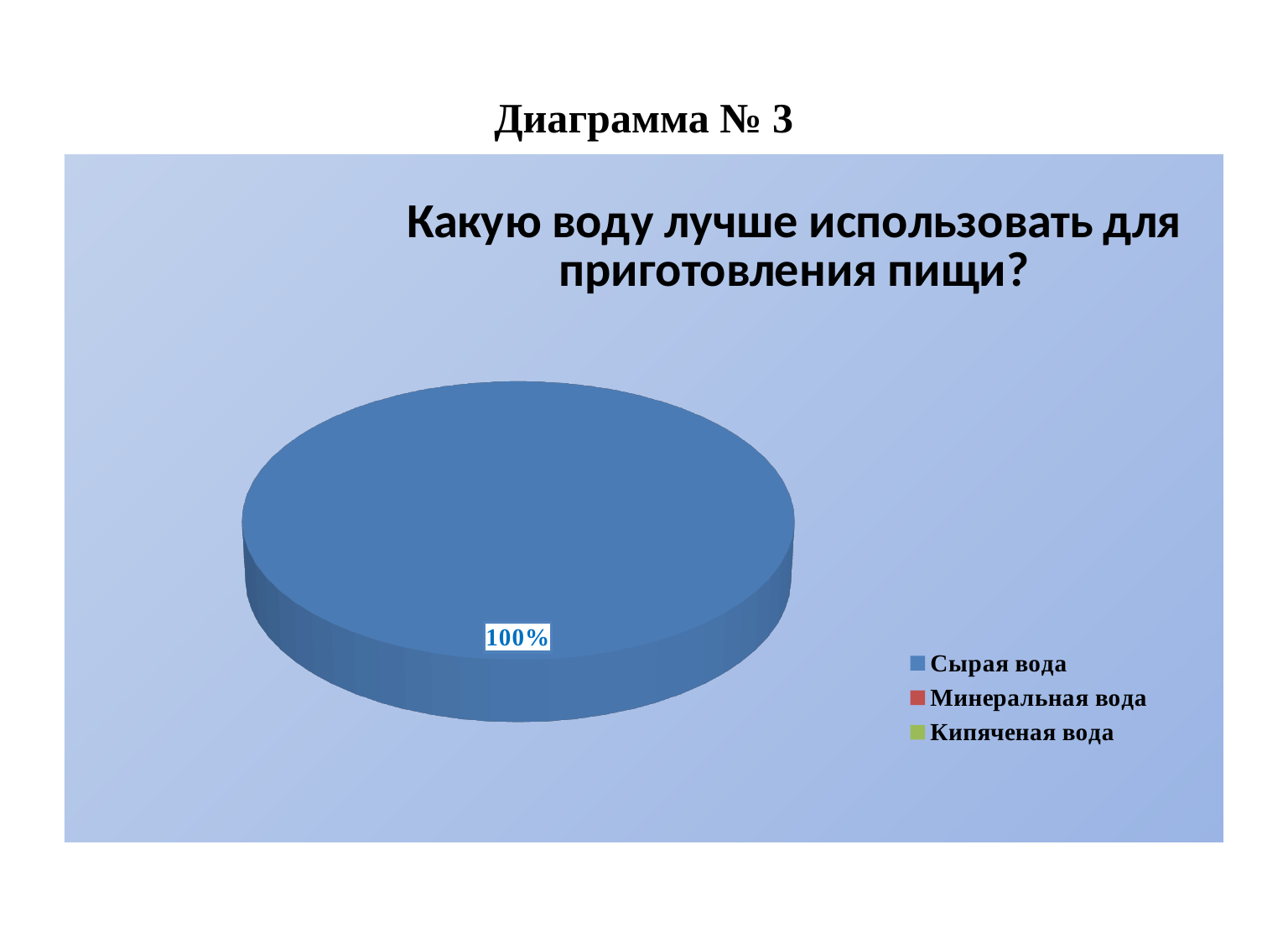
What kind of chart is shown on the slide? pie chart What is the title of the chart? Какую воду лучше использовать для приготовления пищи? What colour is the slice for Сырая вода? blue What share of the pie does Сырая вода take? 100% Is the share for Сырая вода greater or less than 50%? greater How many slices are visible in the pie? 1 How many entries does the legend list? 3 What is the data label printed on the pie slice? 100% Which category has the largest share of the pie? Сырая вода Which is larger, the share for Сырая вода or the share for Минеральная вода? Сырая вода